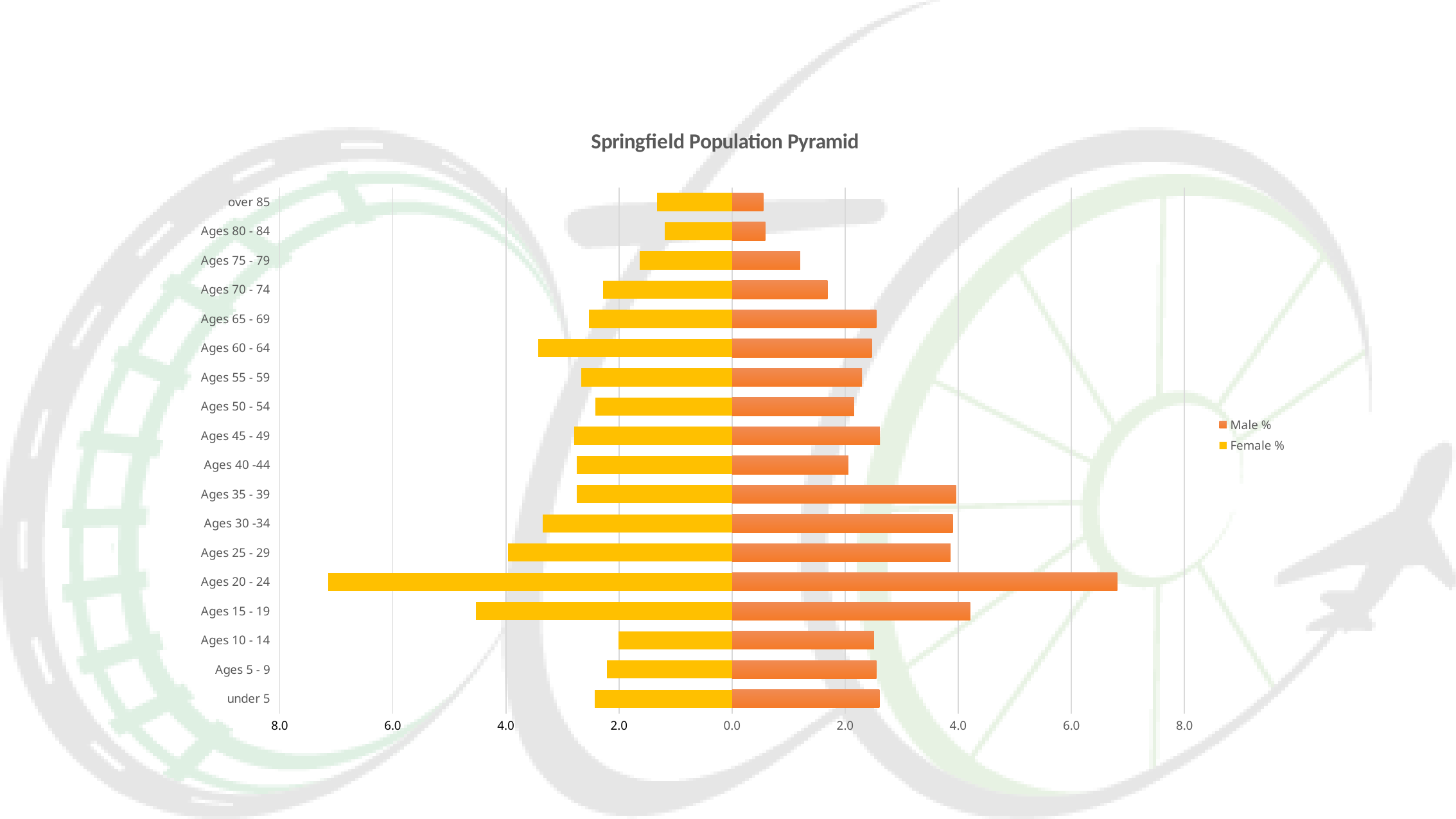
Which colour represents the Female % series? Yellow What kind of chart is shown on the slide? Bar chart How many age categories are plotted on the chart? 18 Is the Female % value for Ages 15 - 19 greater or less than 4.0? greater How many series does the legend list? 2 Is the Male % value for Ages 70 - 74 greater or less than 2.0? less Which age group has the highest Female % value? Ages 20 - 24 What is the title of the chart? Springfield Population Pyramid Is the Male % value for Ages 20 - 24 greater or less than 6.0? greater Which age group has the highest Male % value? Ages 20 - 24 For Ages 60 - 64, which is larger: the Male % or the Female % value? Female %